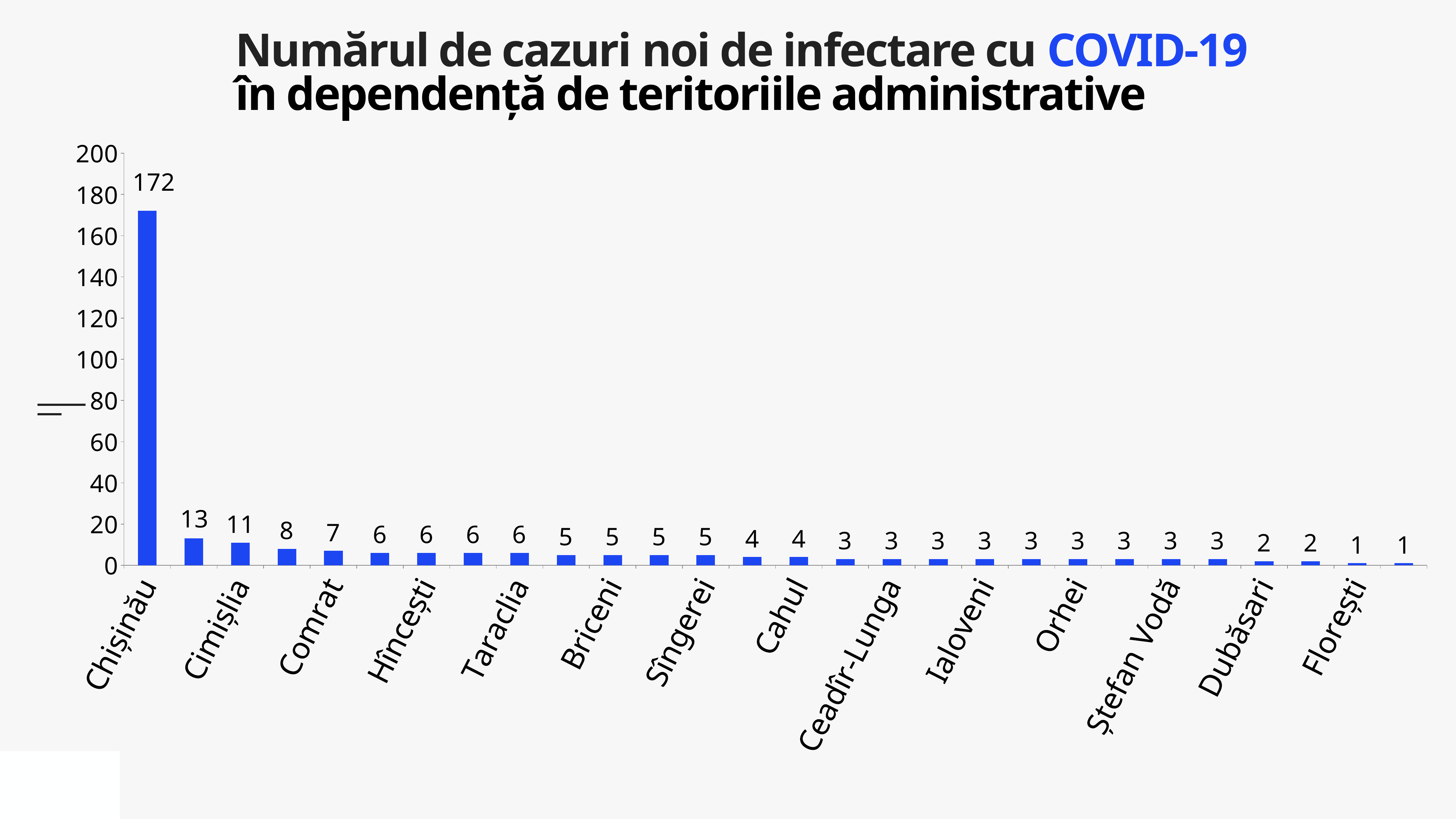
What is the highest value shown on the vertical axis? 200 Which has a larger value, Chișinău or Florești? Chișinău What is the difference between the values for Chișinău and Florești? 171 Do the values rise or fall moving from left to right along the x axis? fall What is the smallest value labelled on any bar in the chart? 1 Is the value for Chișinău greater or less than 160? greater What type of chart is shown on the slide? bar chart Which administrative territory has the highest number of new cases? Chișinău Is the value for Florești greater or less than 20? less What is the number of new cases shown for Florești? 1 How many bars are plotted in the chart? 28 What is the number of new COVID-19 cases shown for Chișinău? 172